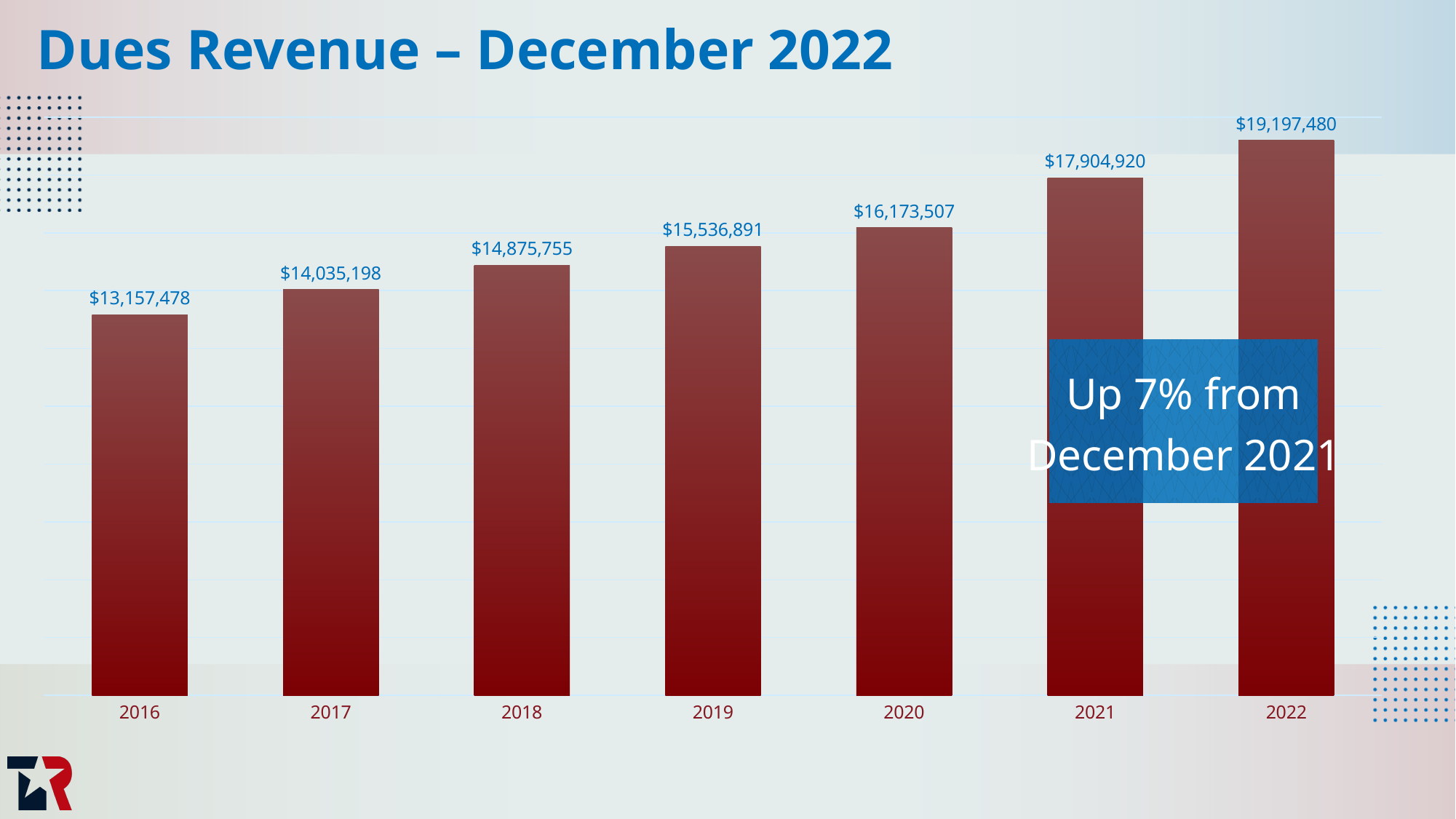
Which year has the lowest dues revenue? 2016 What kind of chart is shown on the slide? Bar chart What is the dues revenue shown for 2021? $17,904,920 Which year has higher dues revenue, 2018 or 2020? 2020 How many years are shown on the chart? 7 Do the dues revenue values rise or fall from 2016 to 2022? Rise According to the callout on the chart, by what percentage is dues revenue up from December 2021? 7% What is the difference in dues revenue between 2017 and 2016? $877,720 What is the dues revenue shown for 2016? $13,157,478 Which year has the highest dues revenue? 2022 What is the difference in dues revenue between 2022 and 2021? $1,292,560 What is the dues revenue shown for 2019? $15,536,891